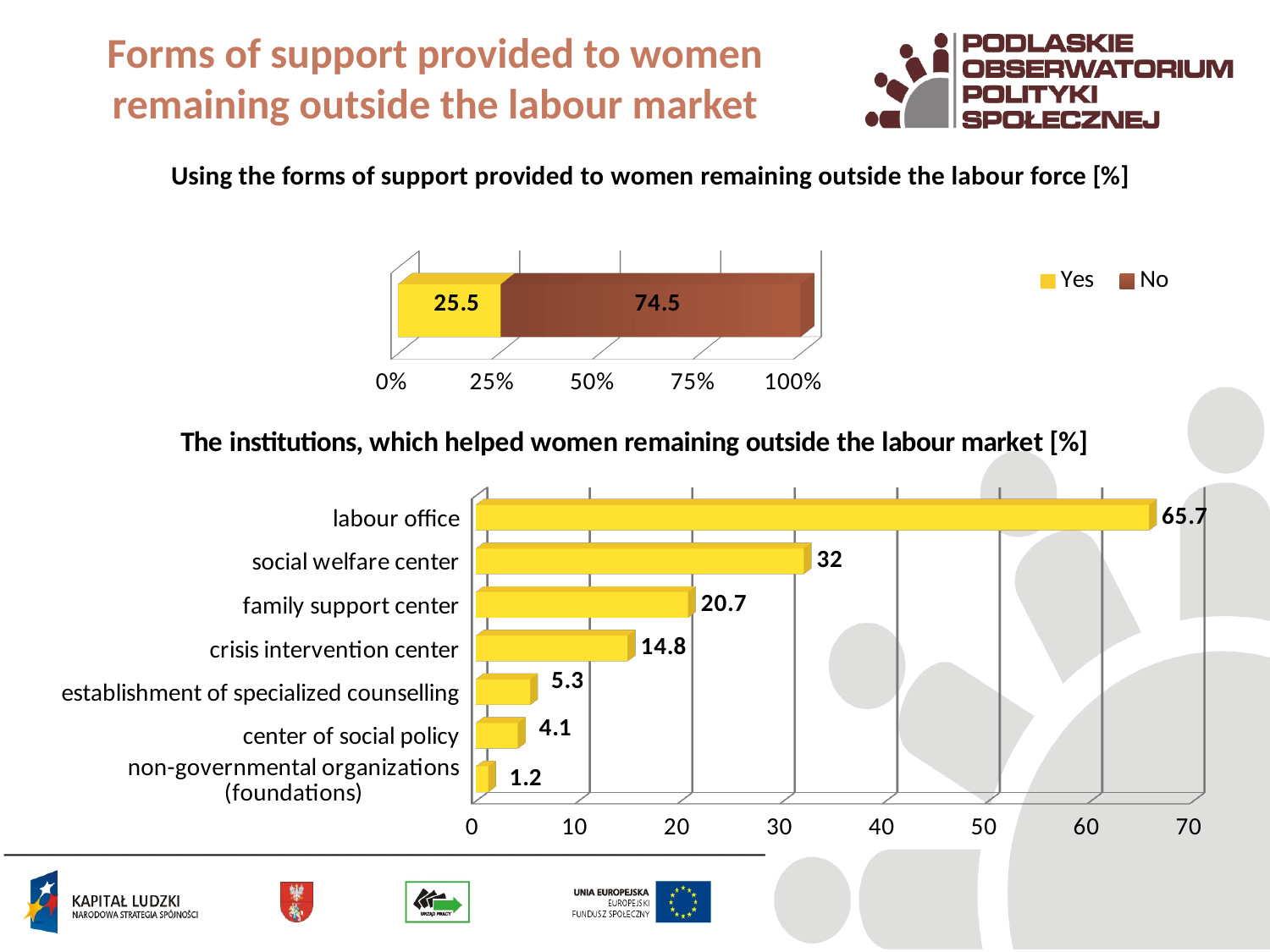
In the top chart 'Using the forms of support provided to women remaining outside the labour force [%]', what is the value for 'Yes'? 25.5 In the top chart 'Using the forms of support provided to women remaining outside the labour force [%]', what is the difference between the 'No' and 'Yes' values? 49 In the top chart 'Using the forms of support provided to women remaining outside the labour force [%]', how many series does the legend list? 2 What kind of chart is the bottom chart 'The institutions, which helped women remaining outside the labour market [%]'? bar chart In the bottom chart 'The institutions, which helped women remaining outside the labour market [%]', which institution has the highest value? labour office In the bottom chart 'The institutions, which helped women remaining outside the labour market [%]', which institution has the lowest value? non-governmental organizations (foundations) In the top chart 'Using the forms of support provided to women remaining outside the labour force [%]', what is the value for 'No'? 74.5 In the bottom chart 'The institutions, which helped women remaining outside the labour market [%]', what is the value for 'labour office'? 65.7 In the bottom chart 'The institutions, which helped women remaining outside the labour market [%]', which is larger: 'establishment of specialized counselling' or 'center of social policy'? establishment of specialized counselling In the bottom chart 'The institutions, which helped women remaining outside the labour market [%]', what is the difference between 'social welfare center' and 'family support center'? 11.3 In the bottom chart 'The institutions, which helped women remaining outside the labour market [%]', how many institutions are shown? 7 In the bottom chart 'The institutions, which helped women remaining outside the labour market [%]', what is the value for 'crisis intervention center'? 14.8